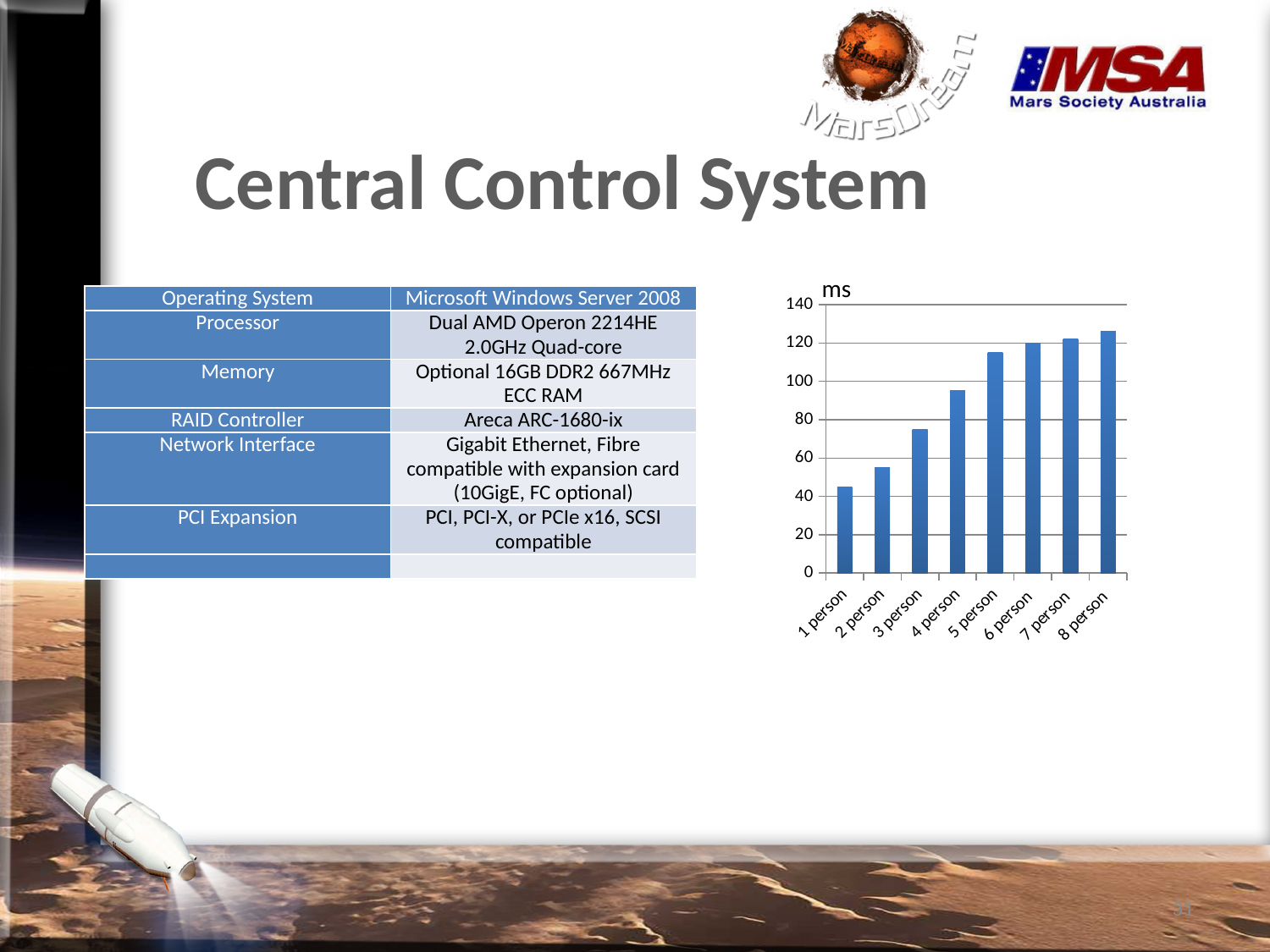
Is the value for 4 person greater or less than 80? greater Is the value for 3 person greater or less than 60? greater Is the value for 1 person greater or less than 60? less How many categories are plotted on the chart? 8 Which is larger, the value for 4 person or the value for 2 person? 4 person Do the values rise or fall as the number of persons increases along the x axis? rise Which category has the highest value on the chart? 8 person What kind of chart is shown on the slide? bar chart Which category has the lowest value on the chart? 1 person What is the title of the chart? ms